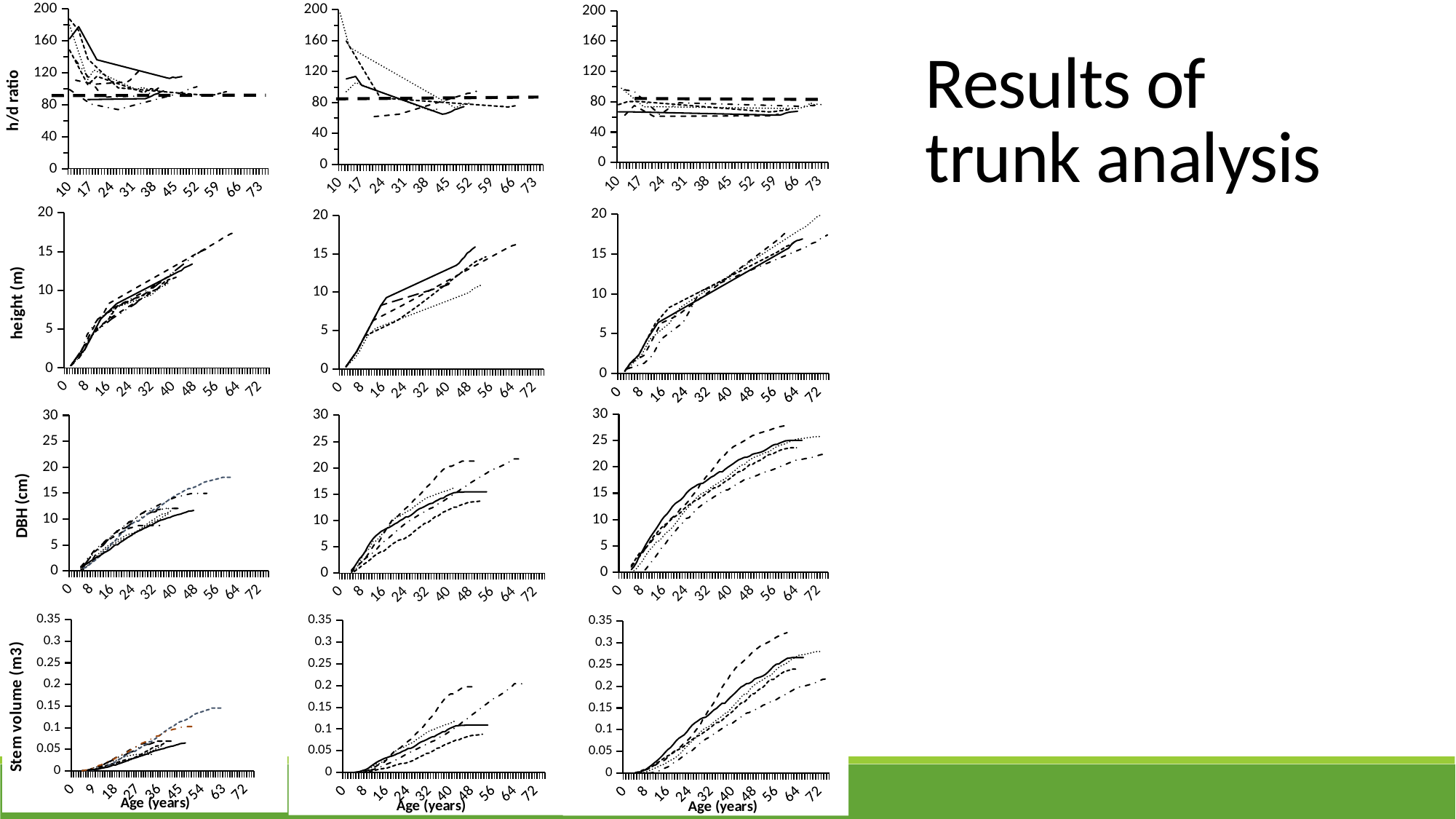
In the right-column DBH (cm) chart, is the highest value reached by any line greater or less than 25? greater In the left-column Stem volume (m3) chart, is the highest value reached by any line greater or less than 0.2? less In the right-column DBH (cm) chart, do the values rise or fall as age increases? rise What is the x-axis label of the bottom row of charts? Age (years) In the left-column h/d ratio chart, is the horizontal dashed reference line greater or less than 80? greater In the left-column h/d ratio chart, do the lines generally rise or fall as age increases? fall How many charts are on the slide? 12 In the middle-column height (m) chart, do the values rise or fall as age increases? rise What is the y-axis label of the third row of charts? DBH (cm) What kind of chart is the top-left panel showing h/d ratio against age? line chart